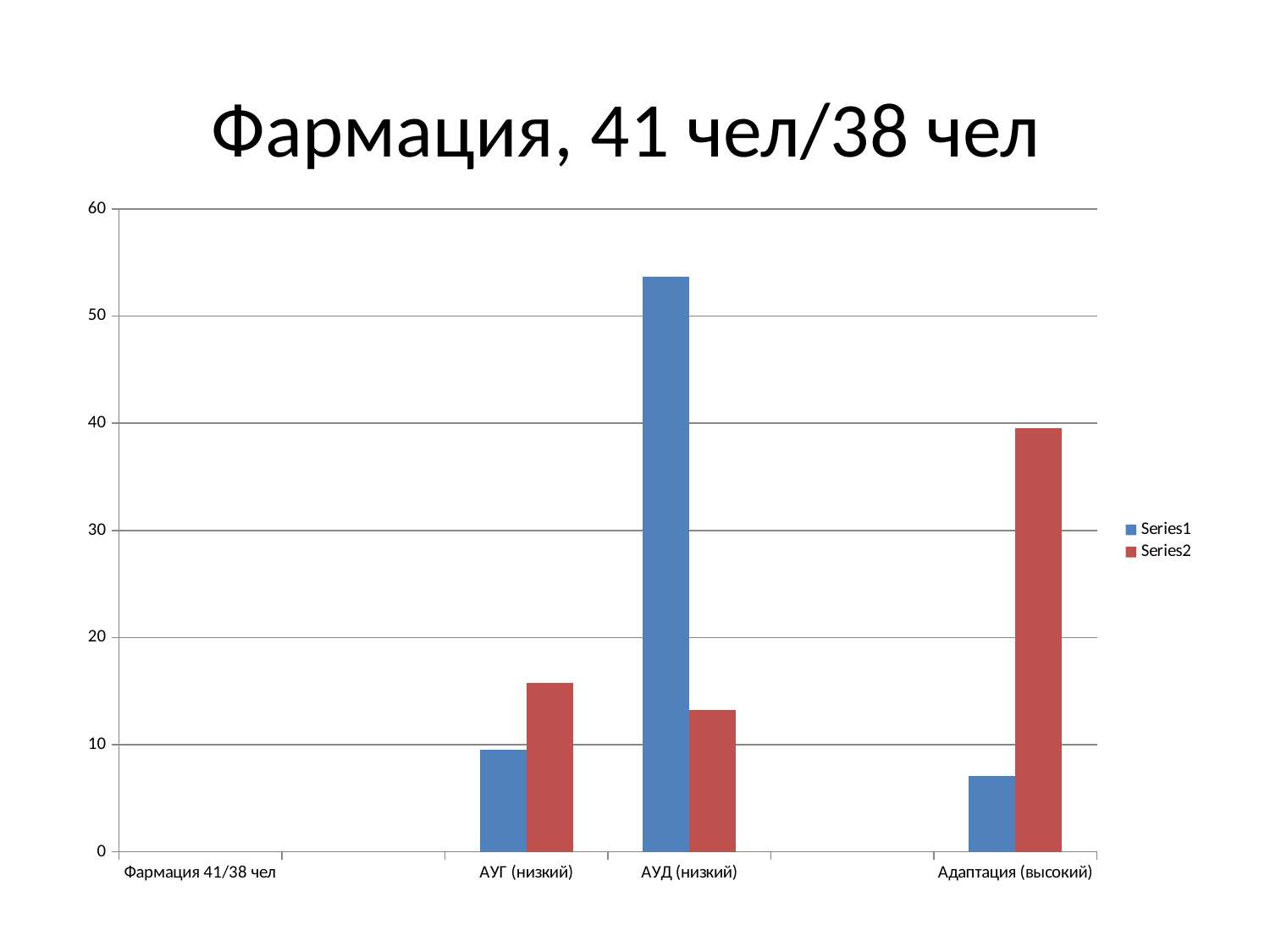
Is the Series1 value for АУД (низкий) greater or less than 50? greater For АУД (низкий), which series has the larger value, Series1 or Series2? Series1 Is the Series1 value for Адаптация (высокий) greater or less than 10? less For Series2, which category has the highest value? Адаптация (высокий) Which series is shown in red in the legend? Series2 For Адаптация (высокий), which series has the larger value, Series1 or Series2? Series2 For Series1, which category has the lowest non-zero value? Адаптация (высокий) What is the title of the chart? Фармация, 41 чел/38 чел How many series does the legend list? 2 What kind of chart is shown on the slide? bar chart How many category labels are shown along the x axis? 4 For Series1, which category has the highest value? АУД (низкий)